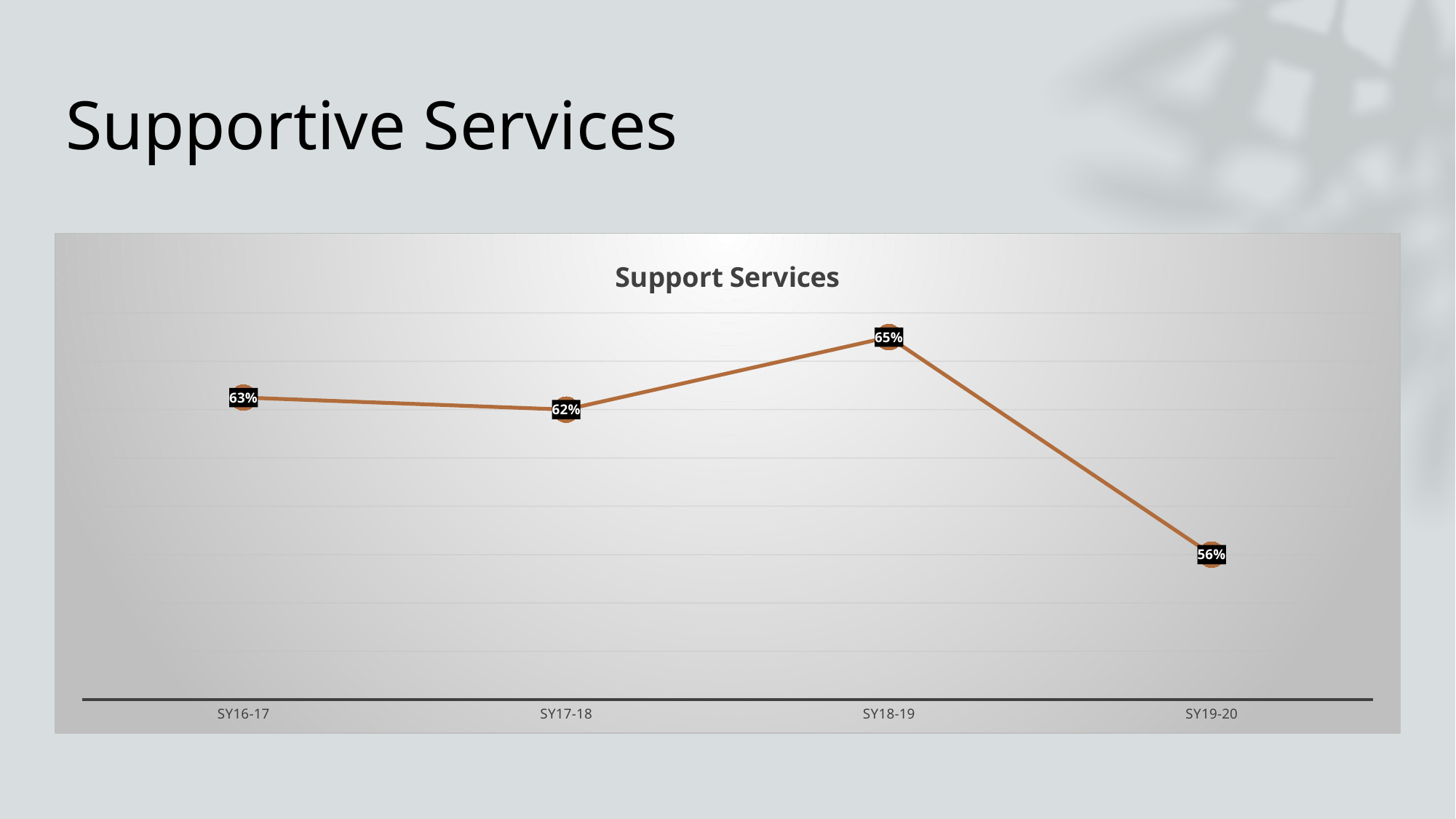
What is the value for SY18-19? 65% How many school years are plotted on the chart? 4 Which school year has the highest value? SY18-19 What is the value for SY16-17? 63% What is the title of the chart? Support Services What is the difference between the values for SY18-19 and SY19-20? 9% What is the value for SY17-18? 62% Which is larger, the value for SY18-19 or the value for SY19-20? SY18-19 What is the value for SY19-20? 56% What kind of chart is shown? Line chart What is the difference between the values for SY16-17 and SY17-18? 1% Which school year has the lowest value? SY19-20